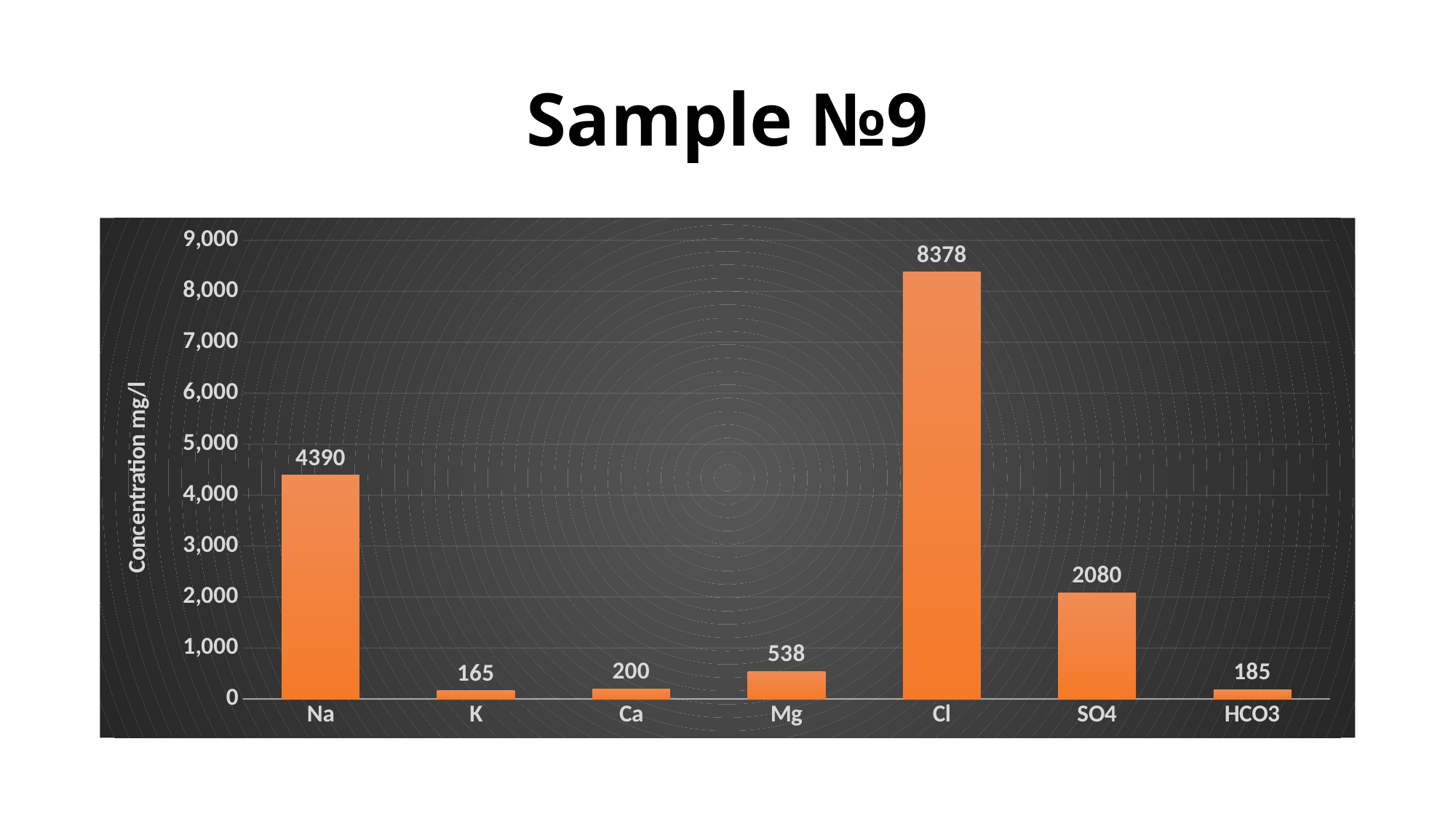
Which is larger, the value for SO4 or the value for Mg? SO4 What is the value shown for SO4? 2080 What is the difference between the Cl and Na concentrations? 3988 Which ion has the lowest concentration? K What kind of chart is shown on the slide? bar chart Which ion has the highest concentration? Cl What is the label of the vertical axis? Concentration mg/l What is the concentration of Na? 4390 How many ions are shown on the x axis? 7 What is the difference between the Ca and K values? 35 What is the concentration of Cl in Sample №9? 8378 What is the value shown for Mg? 538